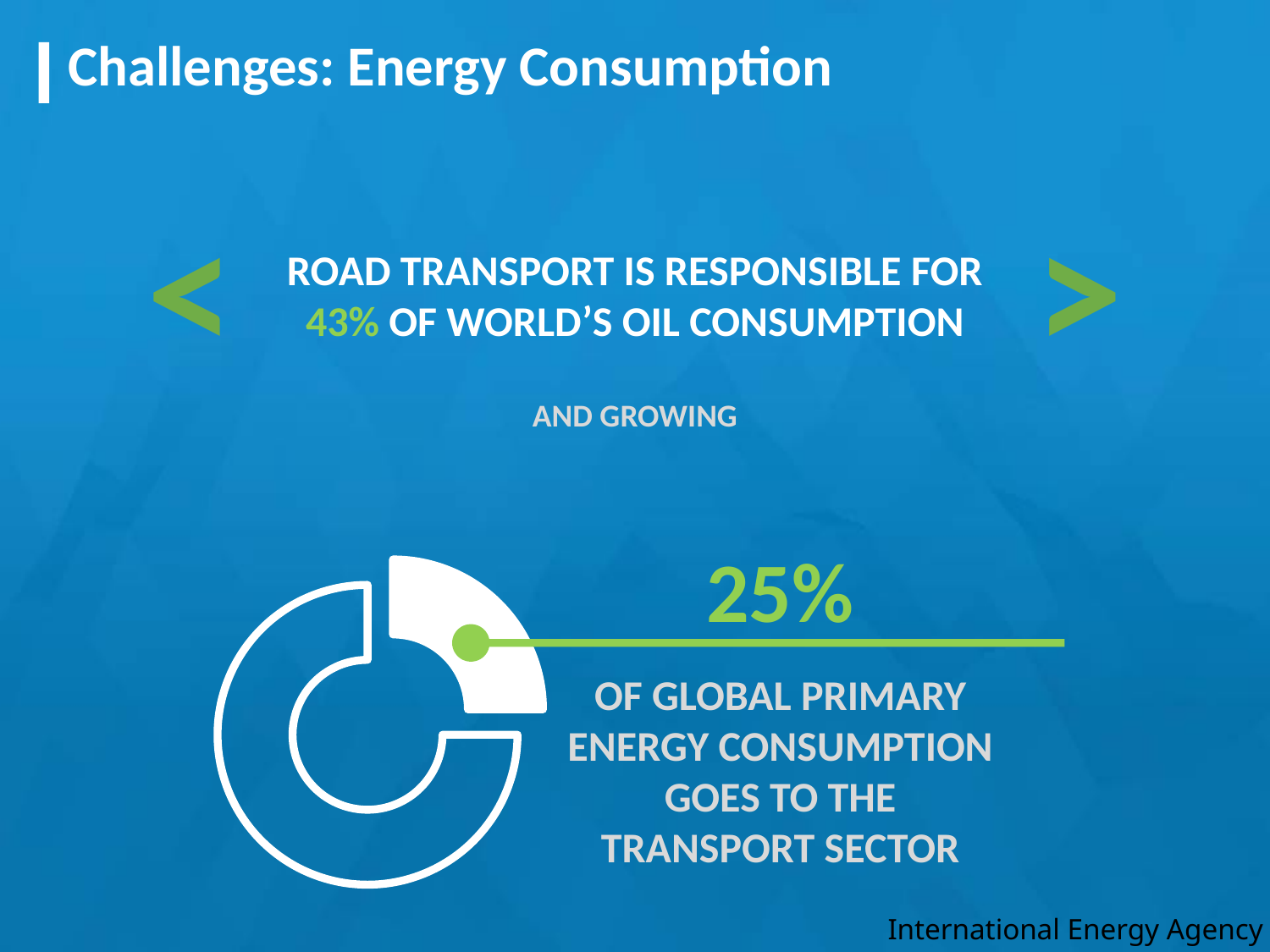
What does the highlighted 25% slice of the donut chart represent? Global primary energy consumption going to the transport sector How many slices does the donut chart have? 2 What source is credited at the bottom of the slide for the chart data? International Energy Agency Which is larger in the donut chart: the highlighted transport-sector slice or the remaining portion? The remaining portion What kind of chart is shown on the slide? Pie (donut) chart What share of global primary energy consumption goes to the transport sector, according to the donut chart? 25% Is the highlighted slice of the donut chart more or less than half of the whole? Less What is the title of the slide containing the donut chart? Challenges: Energy Consumption